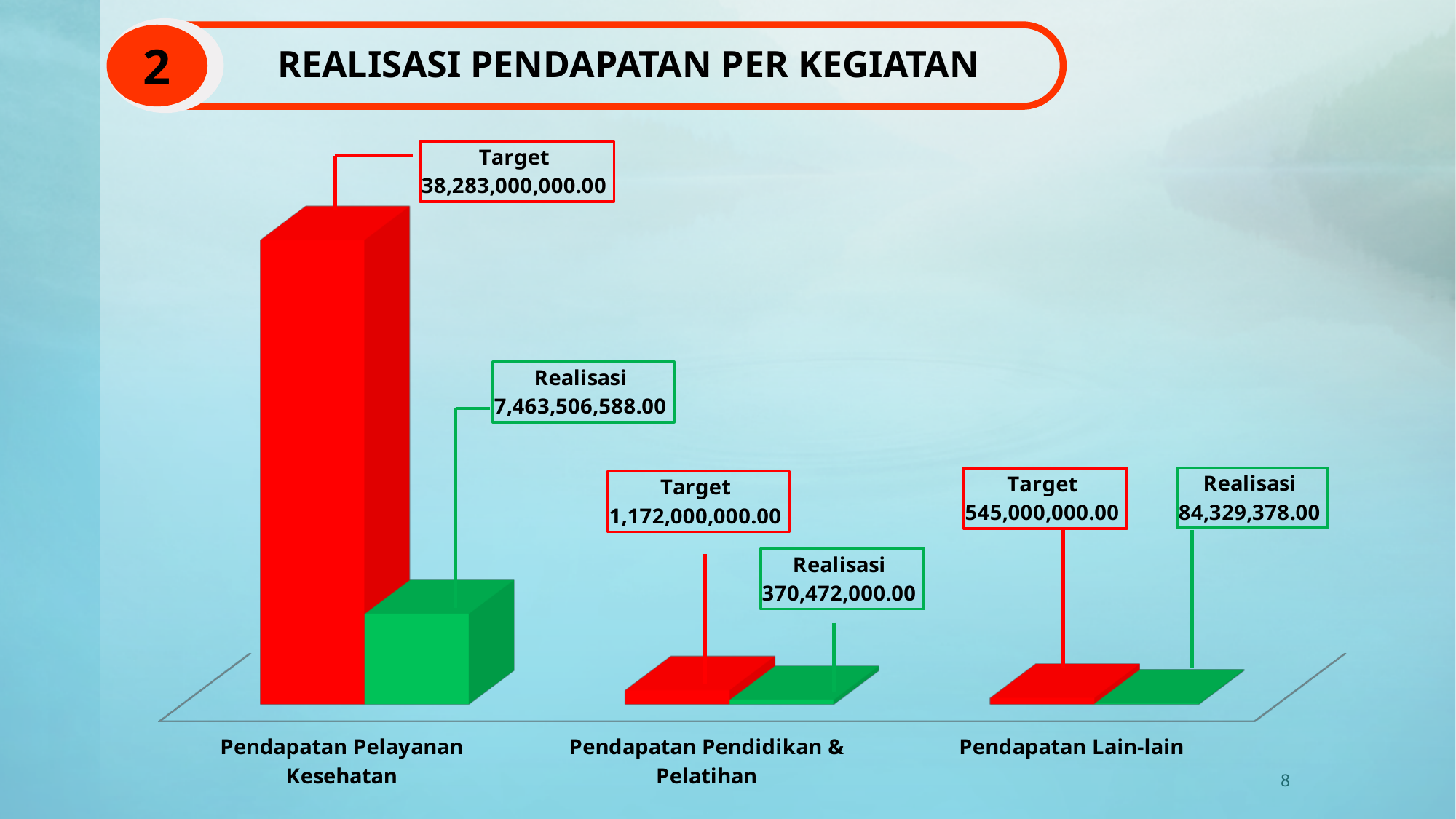
Which category has the lowest Realisasi value? Pendapatan Lain-lain What is the difference between the Target and Realisasi values for Pendapatan Pendidikan & Pelatihan? 801,528,000.00 What is the Realisasi value for Pendapatan Lain-lain? 84,329,378.00 What is the Target value for Pendapatan Pelayanan Kesehatan? 38,283,000,000.00 What is the title of the chart on the slide? REALISASI PENDAPATAN PER KEGIATAN What is the Realisasi value for Pendapatan Pelayanan Kesehatan? 7,463,506,588.00 Which category has the highest Target value? Pendapatan Pelayanan Kesehatan What is the Target value for Pendapatan Pendidikan & Pelatihan? 1,172,000,000.00 What kind of chart is shown on the slide? Bar chart How many categories are shown on the chart? 3 What is the difference between the Target and Realisasi values for Pendapatan Lain-lain? 460,670,622.00 Which is larger: the Realisasi for Pendapatan Pendidikan & Pelatihan or the Target for Pendapatan Lain-lain? Target for Pendapatan Lain-lain